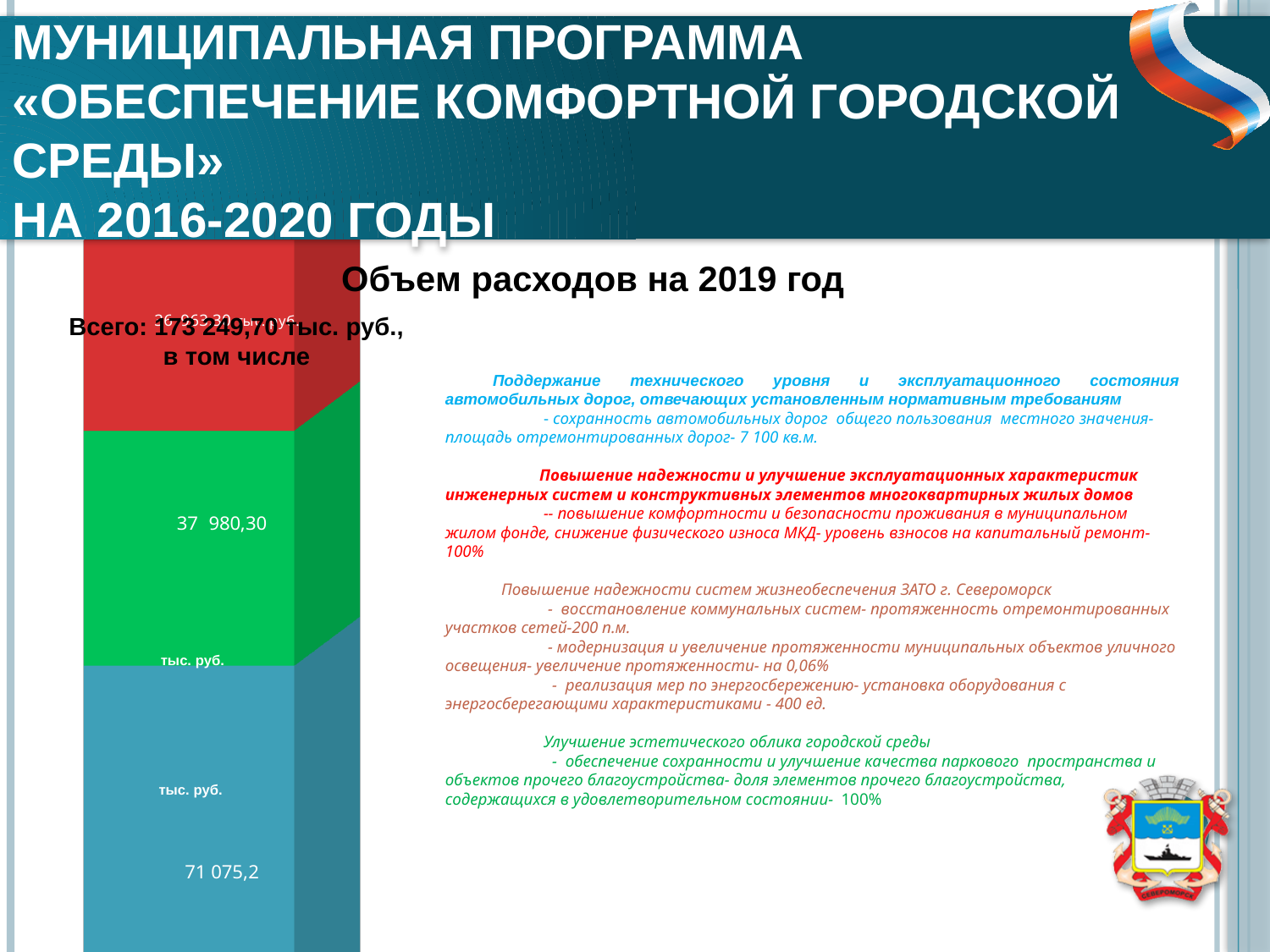
Which segment of the stacked bar is larger, the green one or the blue one? The blue one In what units are the values of the chart expressed? тыс. руб. What kind of chart is shown on the left of the slide? Stacked bar chart What is the total of the stacked bar as stated on the slide (Всего)? 173 249,70 тыс. руб. What is the value printed on the green segment of the stacked bar? 37 980,30 What is the value printed on the blue segment of the stacked bar? 71 075,2 What is the title of the chart on the slide? Объем расходов на 2019 год What is the difference between the blue segment value (71 075,2) and the green segment value (37 980,30)? 33 094,9 Which colour segment of the stacked bar is the largest? Blue How many segments make up the stacked bar? 3